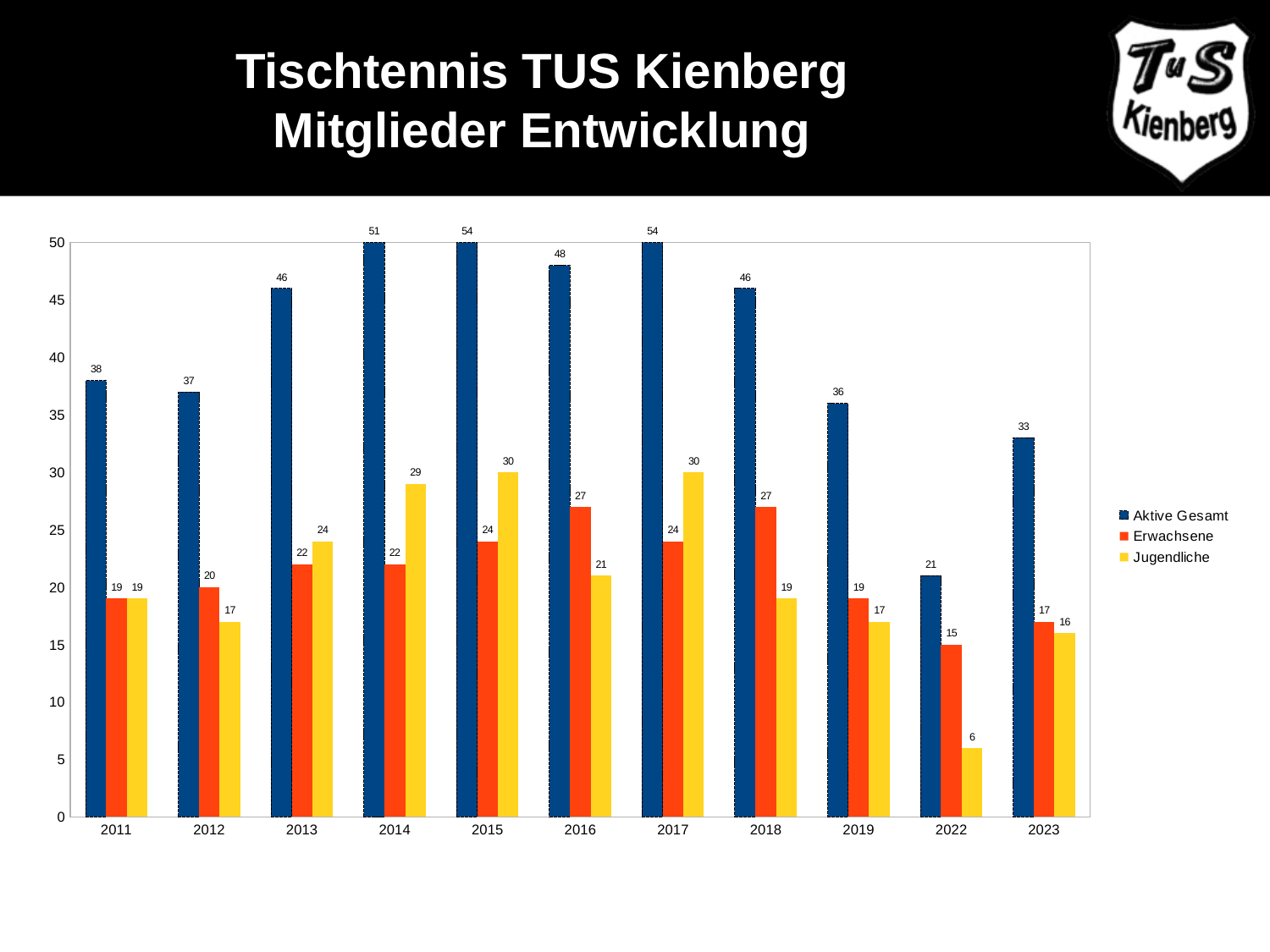
Which series is shown in yellow in the legend? Jugendliche What is the value for Aktive Gesamt in 2014? 51 How many years are shown on the x axis? 11 What kind of chart is shown on the slide? Bar chart Which is larger, Jugendliche in 2013 or Jugendliche in 2016? Jugendliche in 2013 Which year has the lowest value for Aktive Gesamt? 2022 What is the difference between Aktive Gesamt in 2015 and Aktive Gesamt in 2023? 21 What is the difference between Erwachsene and Jugendliche in 2014? 7 Which year has the lowest value for Jugendliche? 2022 What is the value for Jugendliche in 2022? 6 How many series does the legend list? 3 What is the value for Erwachsene in 2016? 27